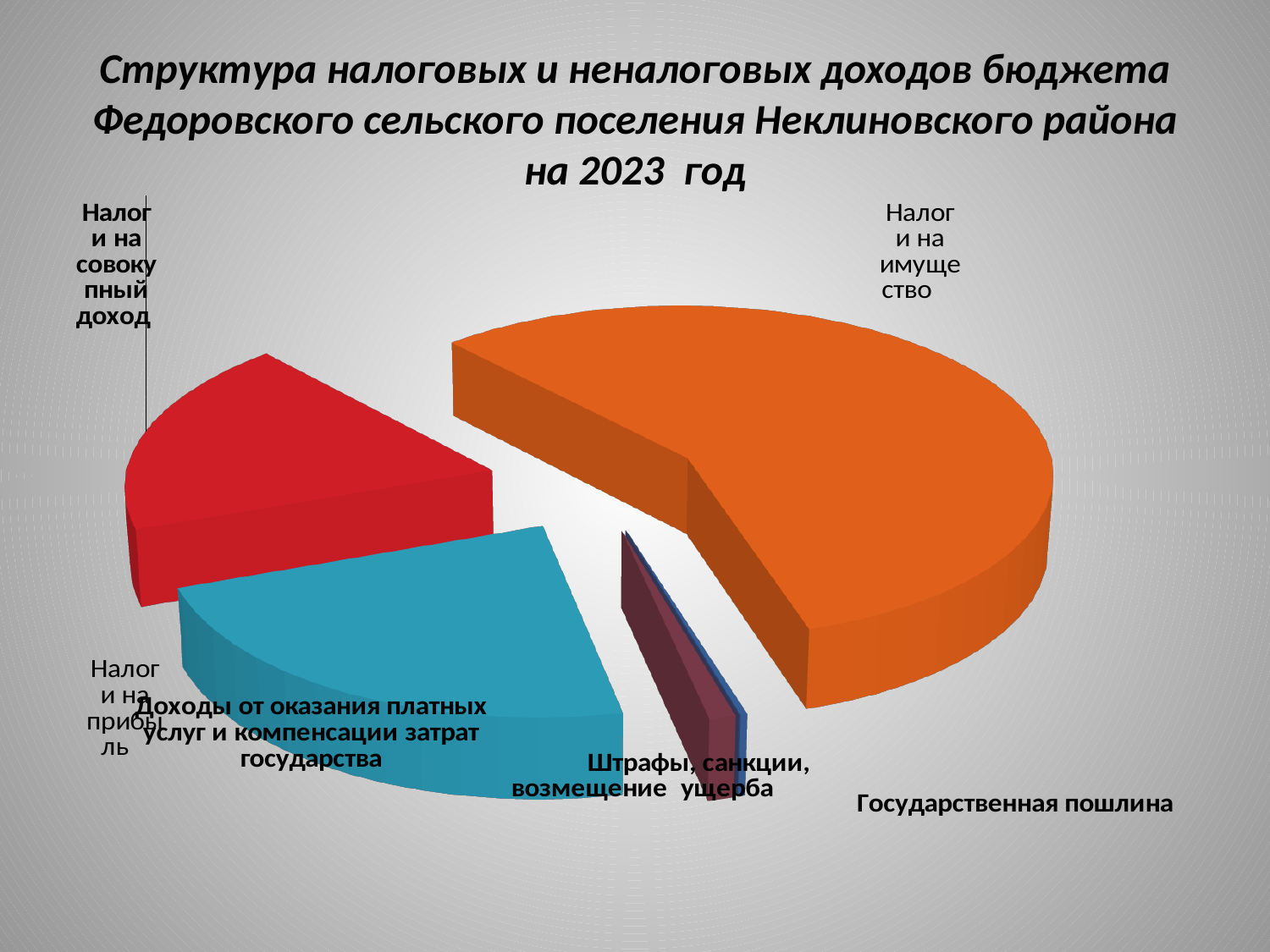
Which slice is larger: Налоги на имущество or Налоги на совокупный доход? Налоги на имущество Which category has the largest slice of the pie? Налоги на имущество Which slice is larger: Налоги на совокупный доход or Штрафы, санкции, возмещение ущерба? Налоги на совокупный доход What colour is the slice for Налоги на имущество? orange For which year does the chart show the structure of budget revenues? 2023 Does the slice for Налоги на имущество take up more or less than half of the pie? more What kind of chart is shown on the slide? pie chart How many categories are labelled on the pie chart? 6 Which slice is larger: Доходы от оказания платных услуг и компенсации затрат государства or Штрафы, санкции, возмещение ущерба? Доходы от оказания платных услуг и компенсации затрат государства